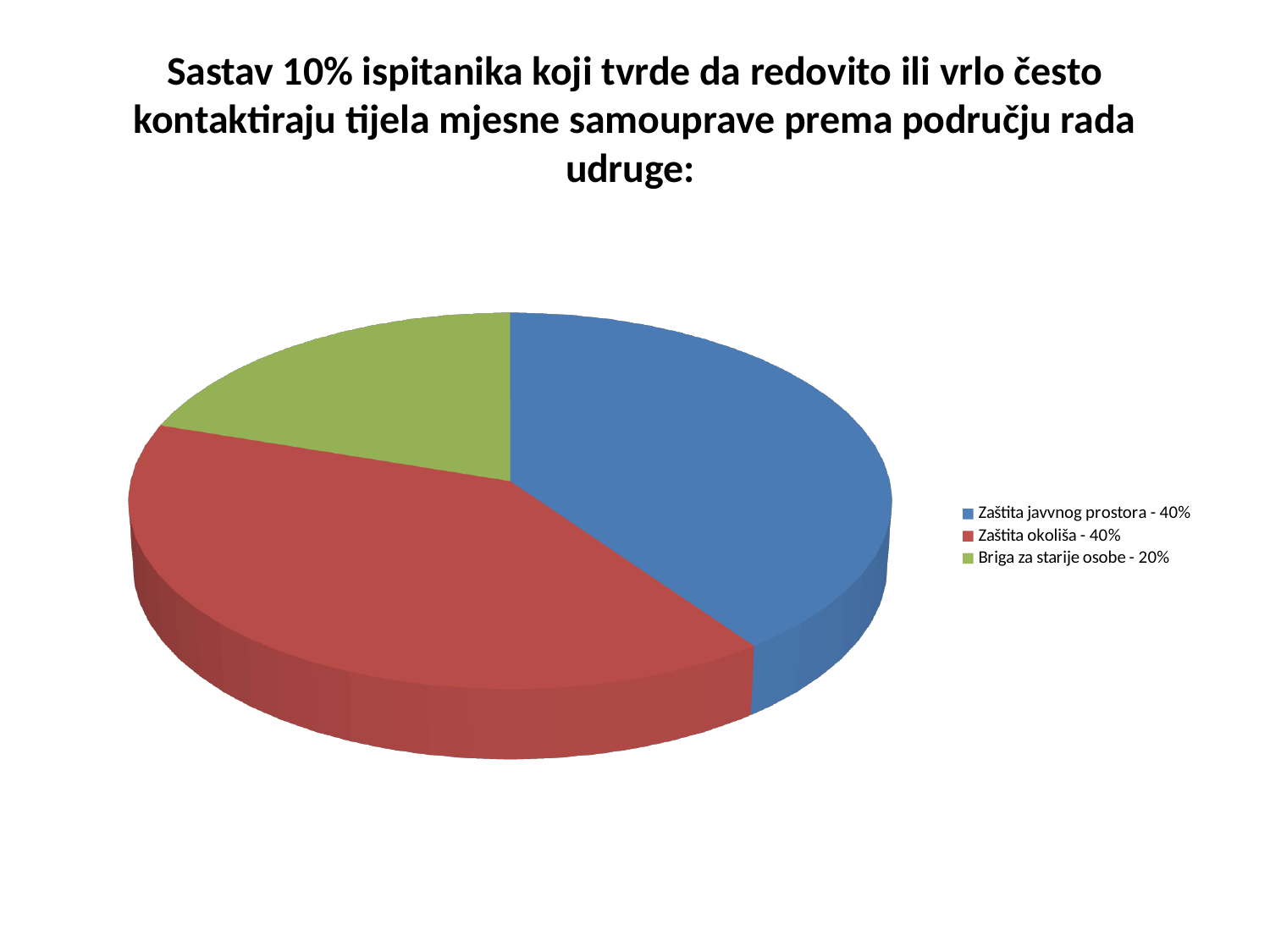
How many slices does the pie chart have? 3 How many entries does the legend list? 3 Do "Zaštita javvnog prostora" and "Zaštita okoliša" have the same share of the pie? Yes What is the value shown for "Zaštita javvnog prostora"? 40% What is the difference between the shares of "Zaštita javvnog prostora" and "Briga za starije osobe"? 20% Which is larger: "Zaštita okoliša" or "Briga za starije osobe"? Zaštita okoliša What colour is the slice for "Briga za starije osobe"? green What share of the pie does "Zaštita okoliša" represent? 40% What kind of chart is shown on the slide? pie chart Which category has the smallest slice of the pie? Briga za starije osobe What share of the pie does "Briga za starije osobe" represent? 20%